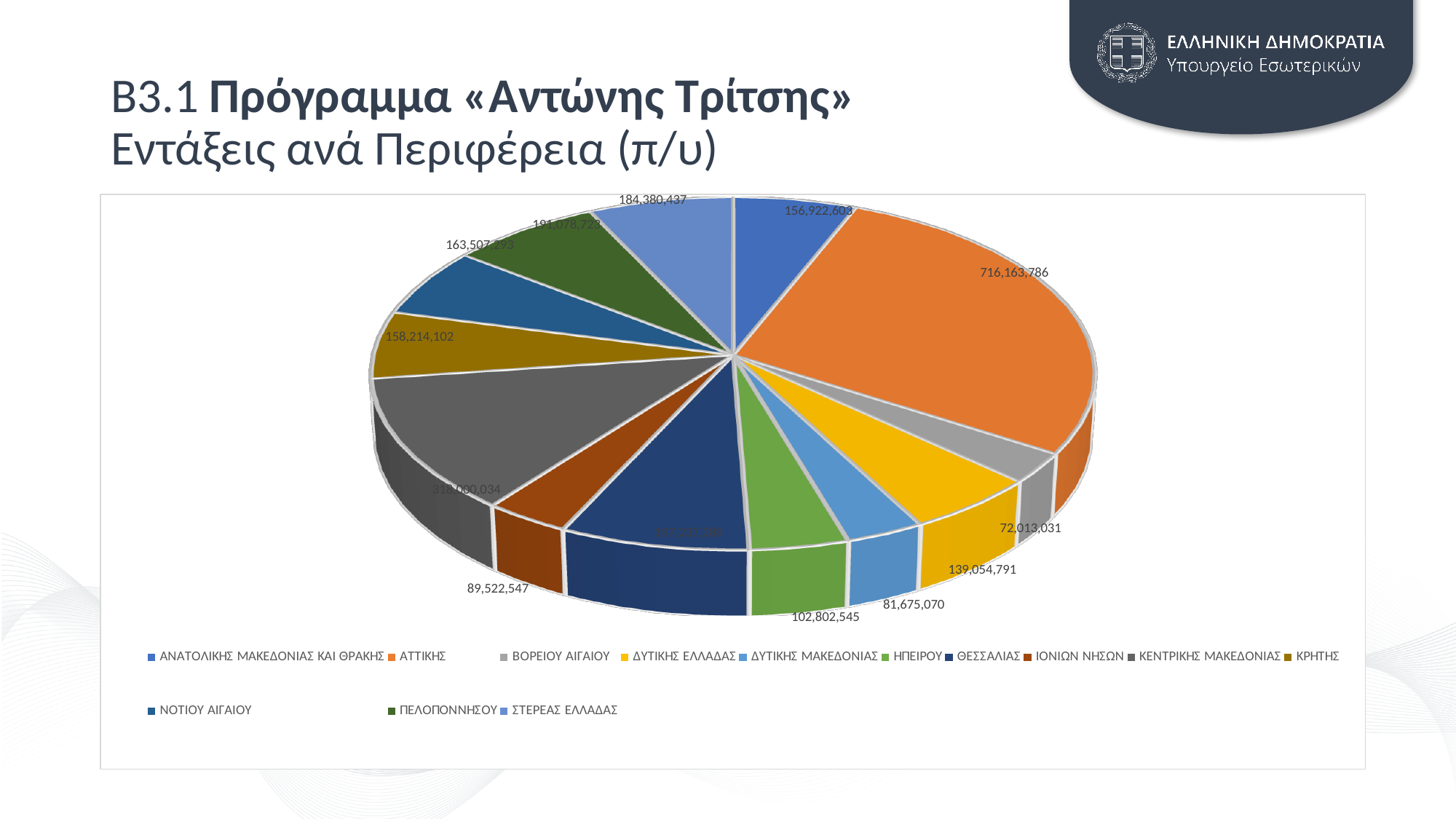
What is the difference between the values for ΣΤΕΡΕΑΣ ΕΛΛΑΔΑΣ and ΑΝΑΤΟΛΙΚΗΣ ΜΑΚΕΔΟΝΙΑΣ ΚΑΙ ΘΡΑΚΗΣ? 27,457,834 What is the difference between the values for ΔΥΤΙΚΗΣ ΕΛΛΑΔΑΣ and ΔΥΤΙΚΗΣ ΜΑΚΕΔΟΝΙΑΣ? 57,379,721 What is the value shown for ΣΤΕΡΕΑΣ ΕΛΛΑΔΑΣ? 184,380,437 How many regions are shown in the pie chart? 13 What is the value shown for ΒΟΡΕΙΟΥ ΑΙΓΑΙΟΥ? 72,013,031 What is the value shown for ΚΡΗΤΗΣ? 158,214,102 Which is larger, the value for ΗΠΕΙΡΟΥ or the value for ΙΟΝΙΩΝ ΝΗΣΩΝ? ΗΠΕΙΡΟΥ What kind of chart is shown on the slide? Pie chart Which region has the smallest slice of the pie? ΒΟΡΕΙΟΥ ΑΙΓΑΙΟΥ What is the value shown for ΑΤΤΙΚΗΣ? 716,163,786 Which region has the largest slice of the pie? ΑΤΤΙΚΗΣ What is the value shown for ΗΠΕΙΡΟΥ? 102,802,545